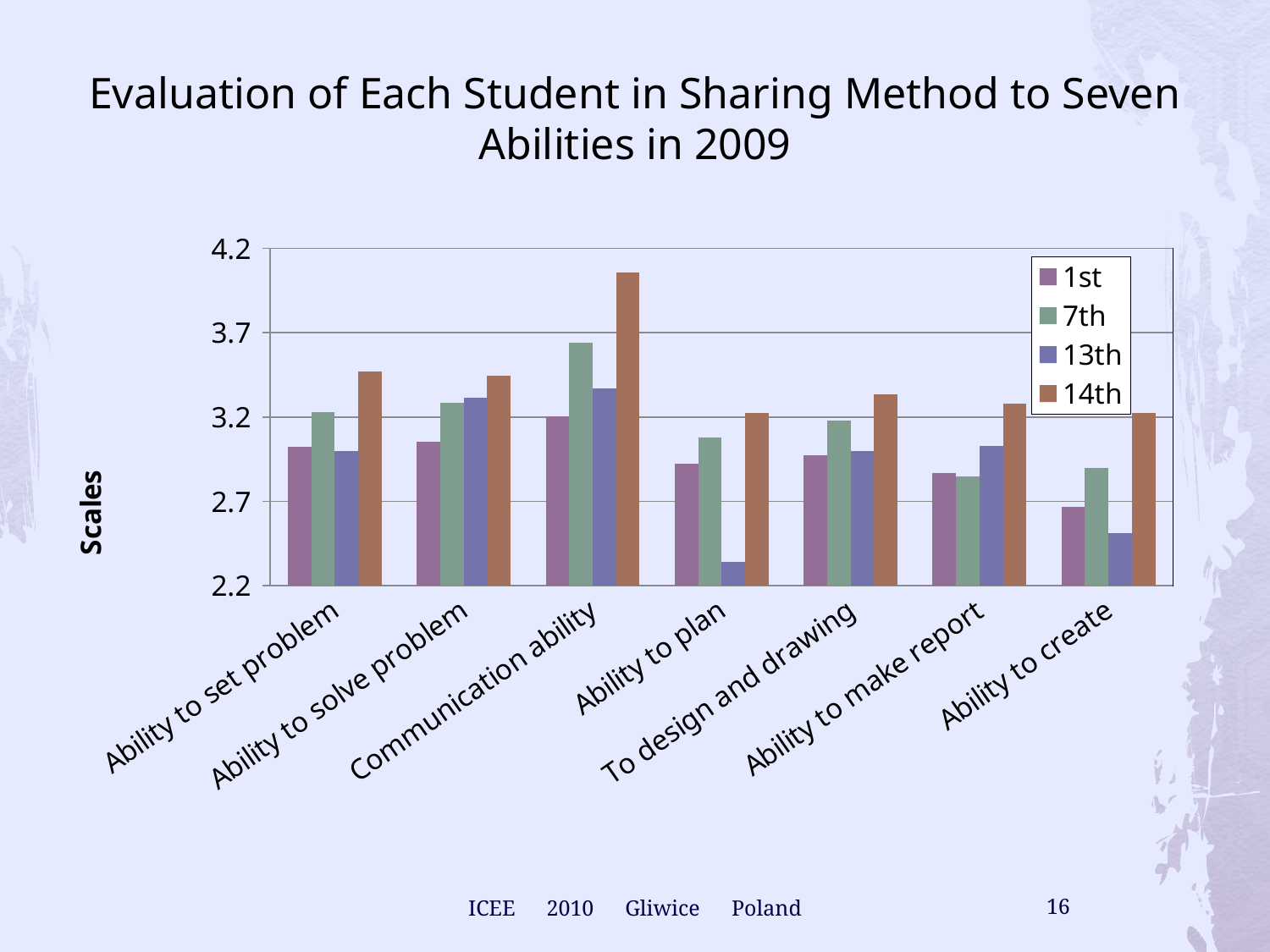
How many ability categories are shown on the x axis of the chart? 7 Is the value of the 13th series for Ability to plan greater or less than 2.7? less Is the value of the 14th series for Communication ability greater or less than 3.7? greater Which series are listed in the chart's legend? 1st, 7th, 13th, 14th For which ability category does the 14th series reach its highest value? Communication ability What kind of chart is shown on the slide? bar chart For Ability to plan, which is larger: the value for the 13th series or the value for the 14th series? 14th What is the label on the vertical axis of the chart? Scales Is the value of the 13th series for Ability to create greater or less than 2.7? less How many series does the chart's legend list? 4 For which ability category does the 13th series have its lowest value? Ability to plan